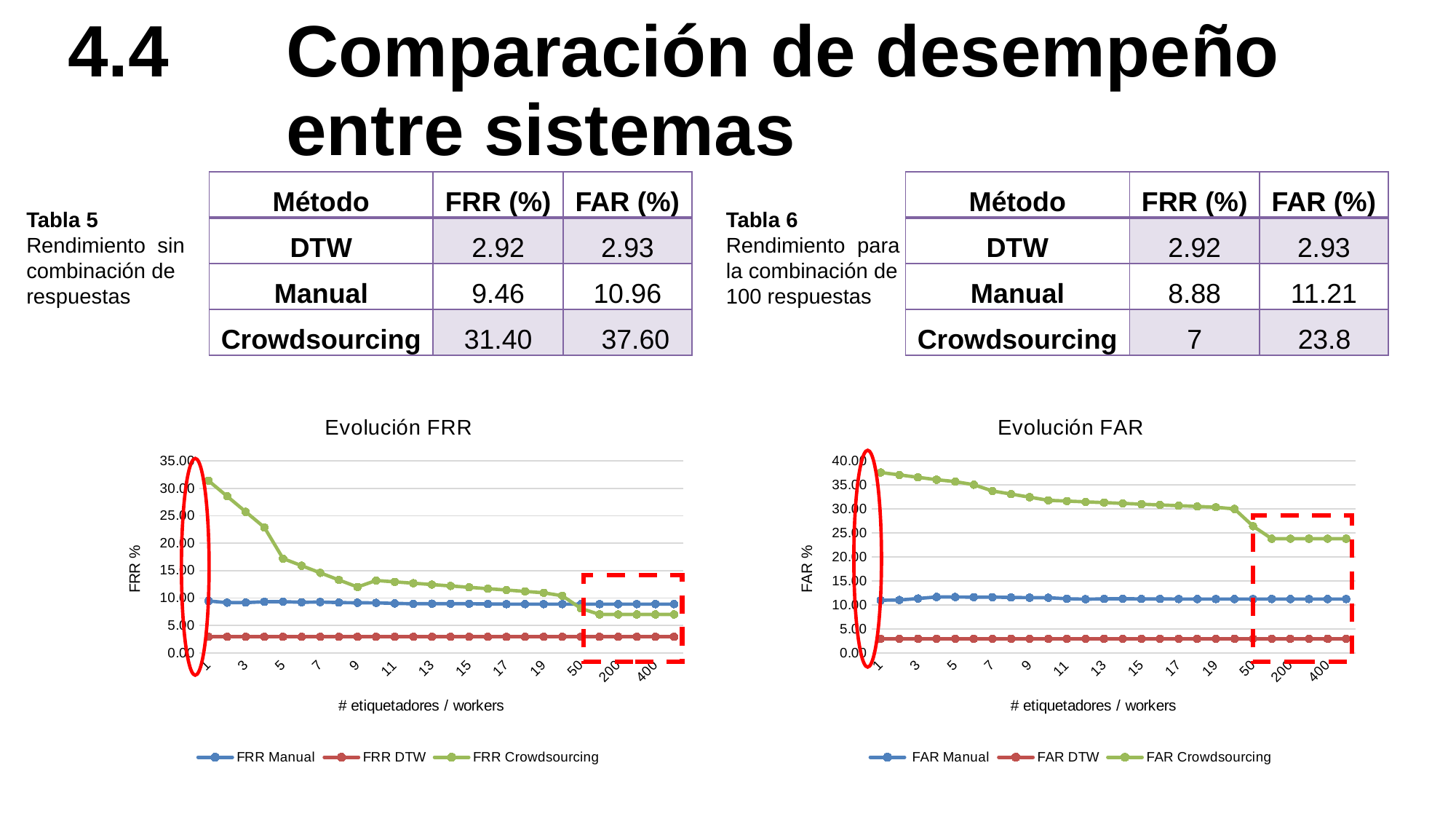
What is the x-axis label of the 'Evolución FRR' chart? # etiquetadores / workers In the 'Evolución FRR' chart, which series is higher at 1 worker, FRR Crowdsourcing or FRR Manual? FRR Crowdsourcing In the 'Evolución FAR' chart, is the value for FAR Crowdsourcing at 1 worker greater or less than 35.00? greater In the 'Evolución FAR' chart, is the value for FAR DTW greater or less than 5.00? less What is the y-axis label of the 'Evolución FAR' chart? FAR % In the 'Evolución FRR' chart, is the value for FRR Crowdsourcing at 400 workers greater or less than 10.00? less What kind of chart is the 'Evolución FRR' chart? Line chart In the 'Evolución FRR' chart, does the FRR Crowdsourcing series rise or fall as the number of workers increases? Fall How many series does the legend of the 'Evolución FAR' chart list? 3 In the 'Evolución FAR' chart, does the FAR Crowdsourcing series rise or fall along the x axis? Fall In the 'Evolución FAR' chart, which series is lower, FAR DTW or FAR Manual? FAR DTW